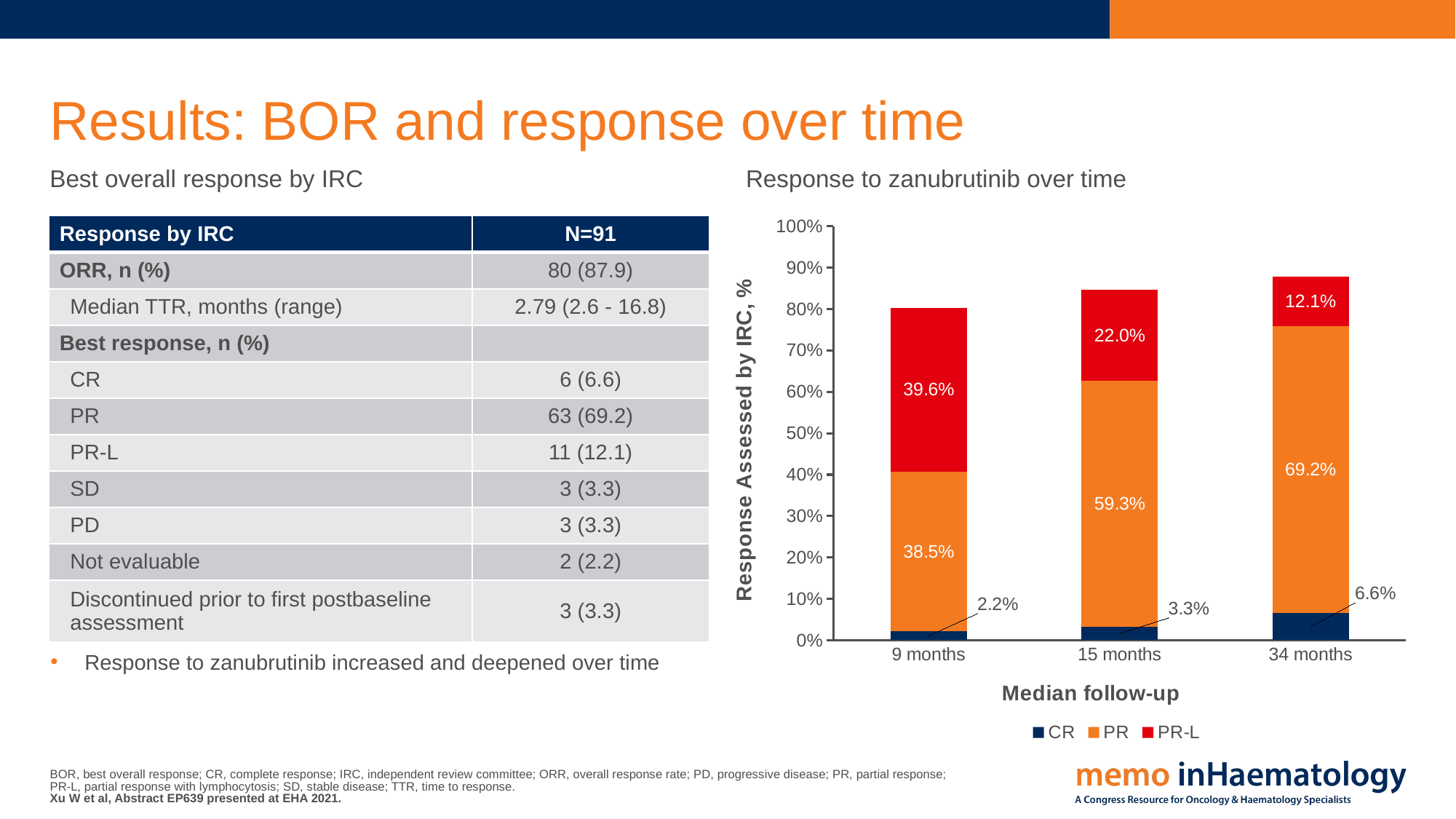
What kind of chart is shown under 'Response to zanubrutinib over time'? Stacked bar chart How many median follow-up time points are shown on the x axis? 3 At which median follow-up time point is the PR value highest? 34 months Does the CR value rise or fall from 9 months to 34 months? Rise How many series does the legend list? 3 At which median follow-up time point is the PR-L value lowest? 34 months What is the difference between the PR value at 34 months and the PR value at 9 months? 30.7% What is the total of the stacked bar for 34 months median follow-up? 87.9% What is the PR-L value at 9 months median follow-up? 39.6% Which is larger: the PR-L value at 15 months or the PR-L value at 34 months? PR-L at 15 months What is the CR value at 34 months median follow-up? 6.6% What is the PR value at 15 months median follow-up? 59.3%